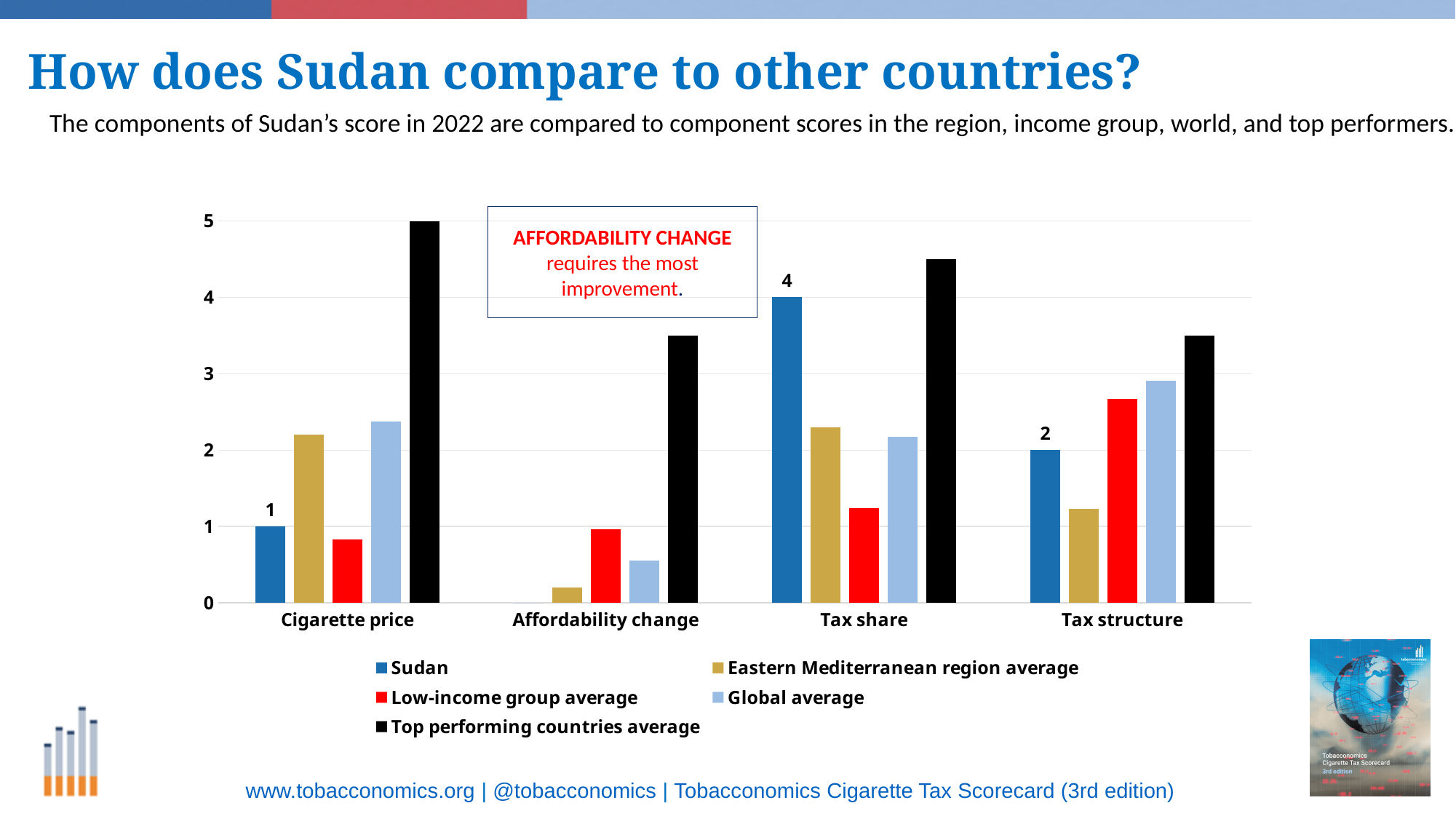
What kind of chart is shown on the slide? bar chart What is Sudan's score for Tax structure? 2 Which is larger for Sudan: the Cigarette price score or the Tax structure score? Tax structure How many components (categories) are shown on the x axis? 4 Is the Low-income group average for Cigarette price greater or less than 1? less What is Sudan's score for Tax share? 4 Is the Top performing countries average for Affordability change greater or less than 3? greater How many series does the legend list? 5 In which component does Sudan have its highest score? Tax share What is the Top performing countries average for Cigarette price? 5 What is the difference between Sudan's Tax share score and its Tax structure score? 2 What is Sudan's score for Cigarette price? 1